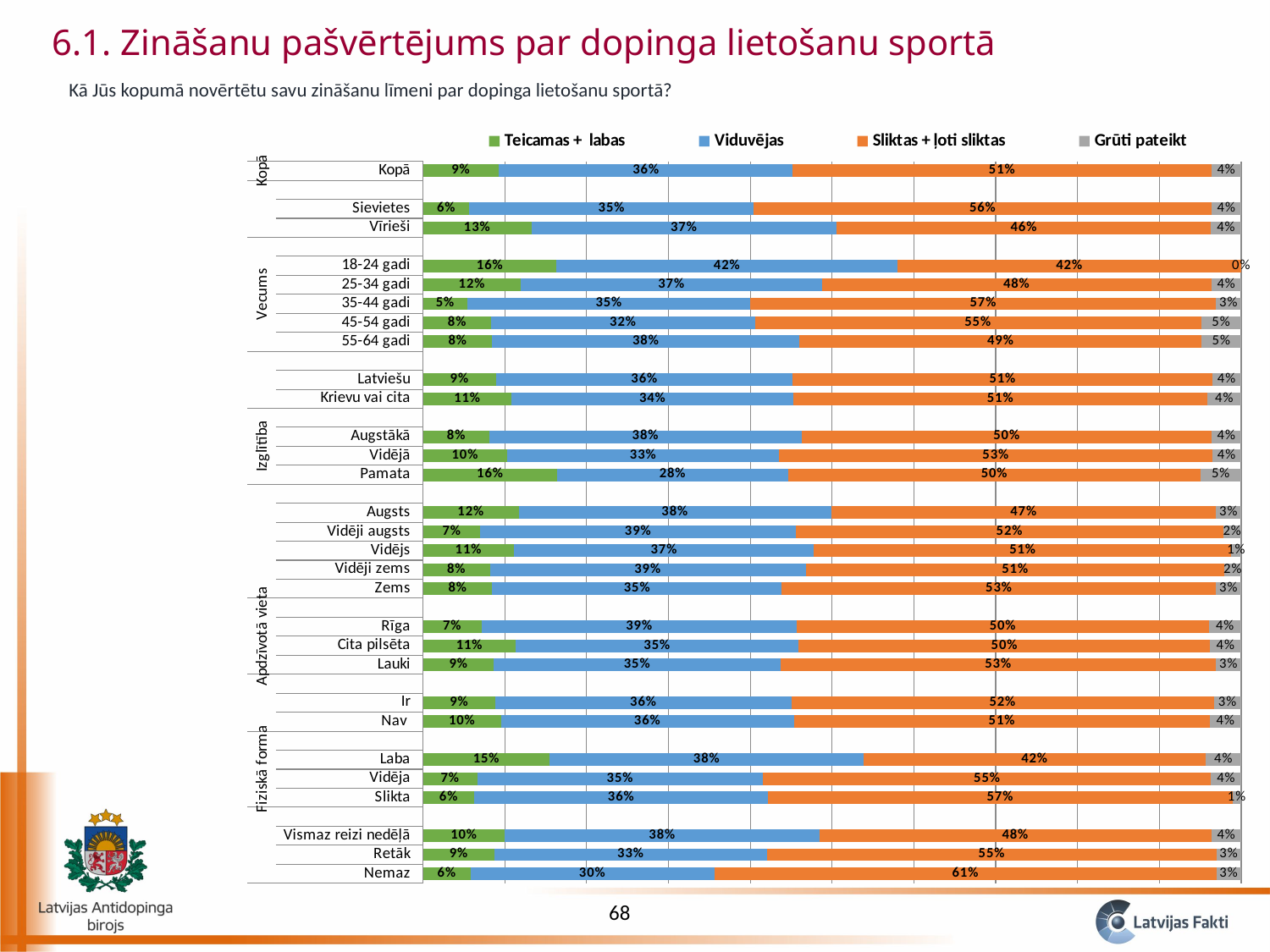
Which category has the lowest Viduvējas value? Pamata What is the Sliktas + ļoti sliktas value for the Nemaz category? 61% What is the Grūti pateikt value for the 18-24 gadi category? 0% What is the total of the four segments in the Kopā bar? 100% What is the Teicamas + labas value for the 18-24 gadi category? 16% What colour represents the Viduvējas series in the legend? Blue How many series does the legend list? 4 Which has a larger Sliktas + ļoti sliktas value, Sievietes or Vīrieši? Sievietes Which category has the highest Sliktas + ļoti sliktas value? Nemaz What is the difference in the Teicamas + labas value between Vīrieši and Sievietes? 7 percentage points What percentage of the Kopā group rated their knowledge as Viduvējas? 36% What kind of chart is shown on the slide? Stacked bar chart